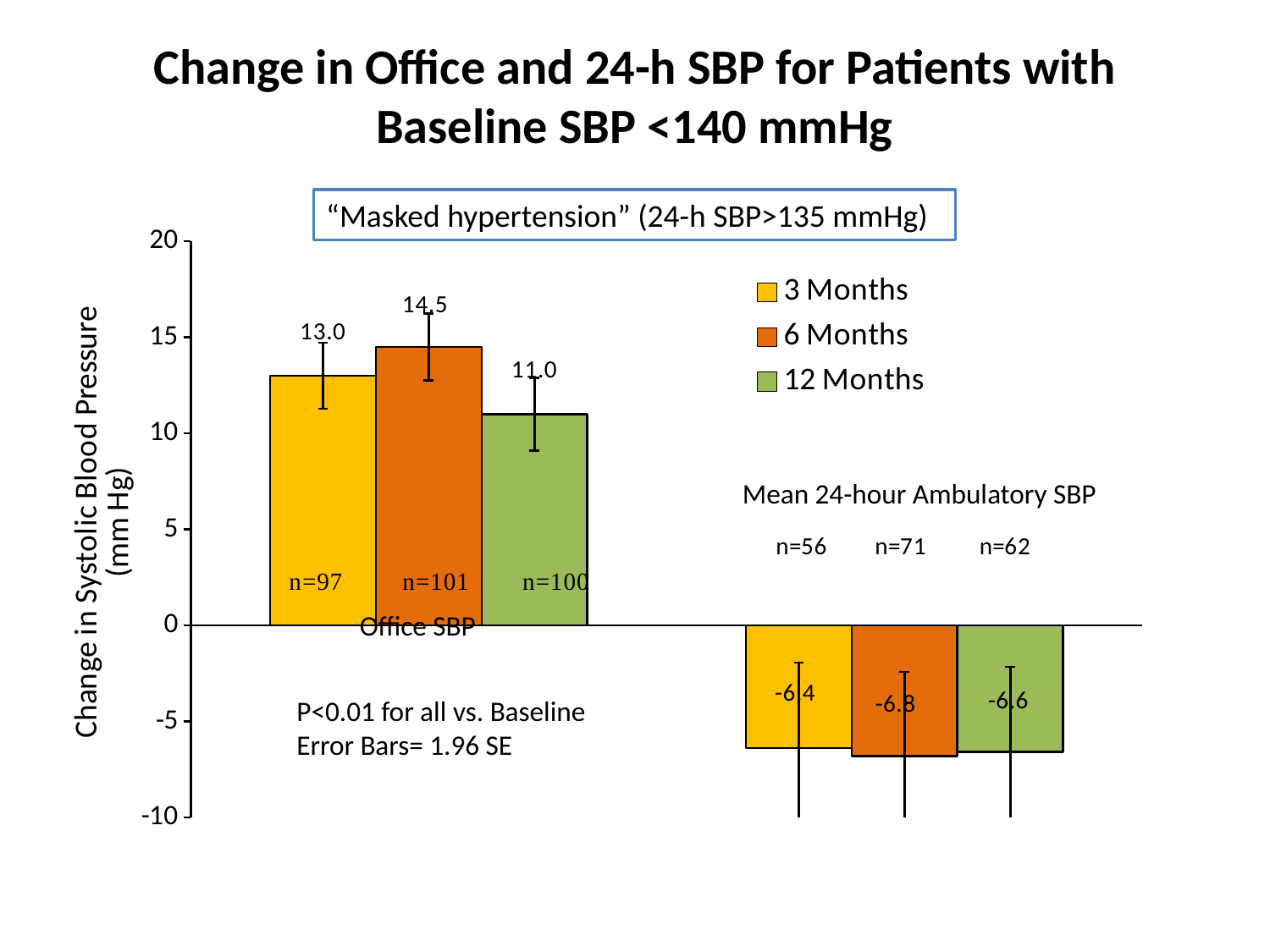
Which time point shows the smallest change in Office SBP? 12 Months Is the Office SBP change at 3 Months greater or less than 10? greater What is the change in Office SBP at 6 Months? 14.5 Which time point shows the largest change in Office SBP? 6 Months How many series does the legend list? 3 What is the change in Mean 24-hour Ambulatory SBP at 6 Months? -6.8 What is the difference between the Office SBP change at 6 Months and at 12 Months? 3.5 What is the sample size (n) for the 12 Months bar in the Mean 24-hour Ambulatory SBP group? n=62 What is the change in Mean 24-hour Ambulatory SBP at 3 Months? -6.4 What is the change in Office SBP at 3 Months? 13.0 What is the change in Office SBP at 12 Months? 11.0 What kind of chart is shown on the slide? Bar chart